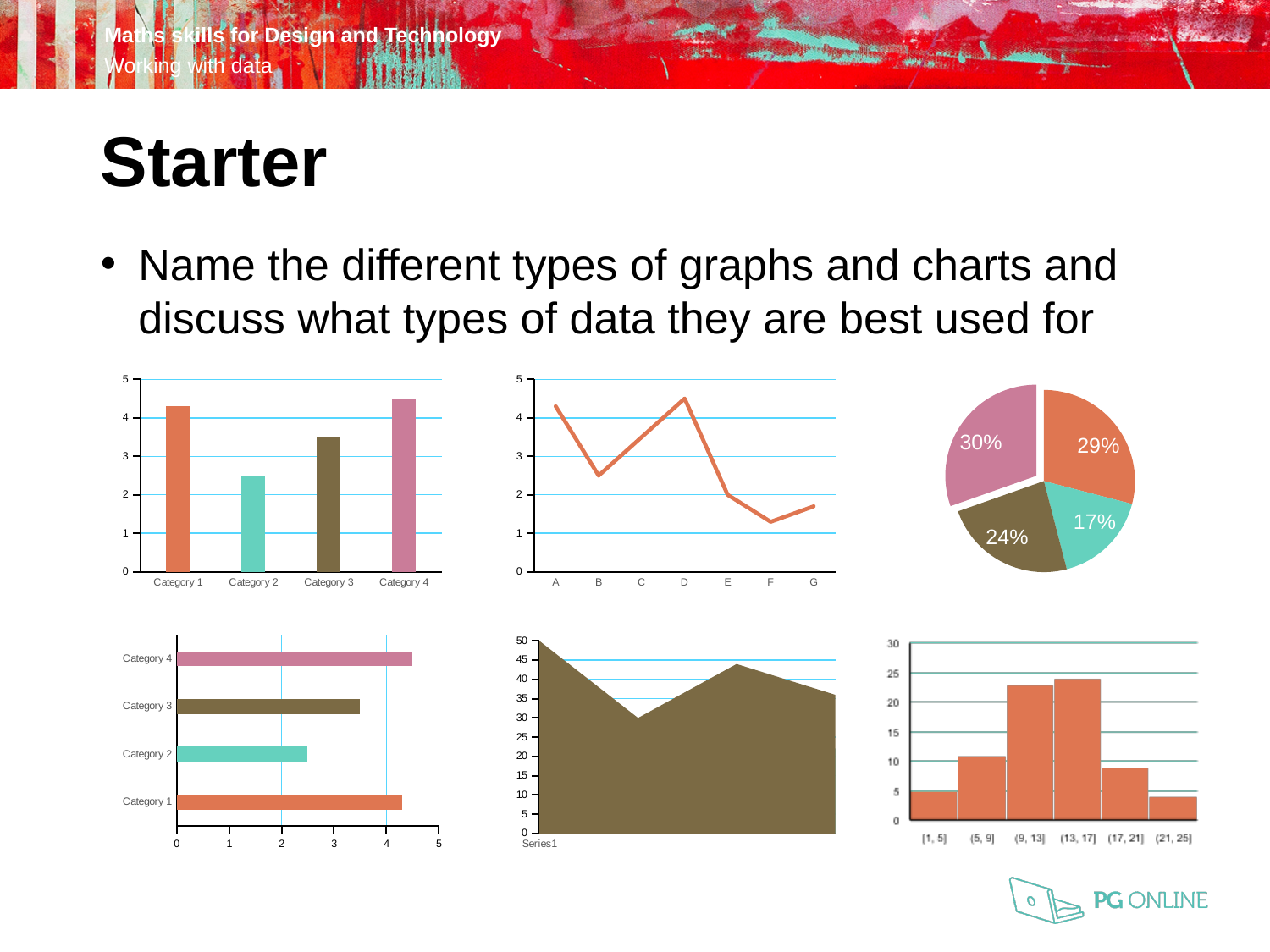
In the top-middle line chart, which point has the lowest value? F In the top-left bar chart, which category has the lowest value? Category 2 In the top-right pie chart, what is the share of the largest slice? 30% In the bottom-left horizontal bar chart, is the value for Category 3 greater or less than 3? greater In the bottom-right histogram, which bin has the highest value? (13, 17] In the top-middle line chart, which point has the highest value? D In the bottom-middle area chart, what series name is shown in the legend? Series1 In the top-left bar chart, is the value for Category 2 greater or less than 3? less In the top-right pie chart, what is the difference between the largest and smallest slices? 13% In the top-middle line chart, how many points are plotted along the x axis? 7 What kind of chart is the top-left chart on the slide? bar chart In the top-left bar chart, how many categories are shown on the x axis? 4